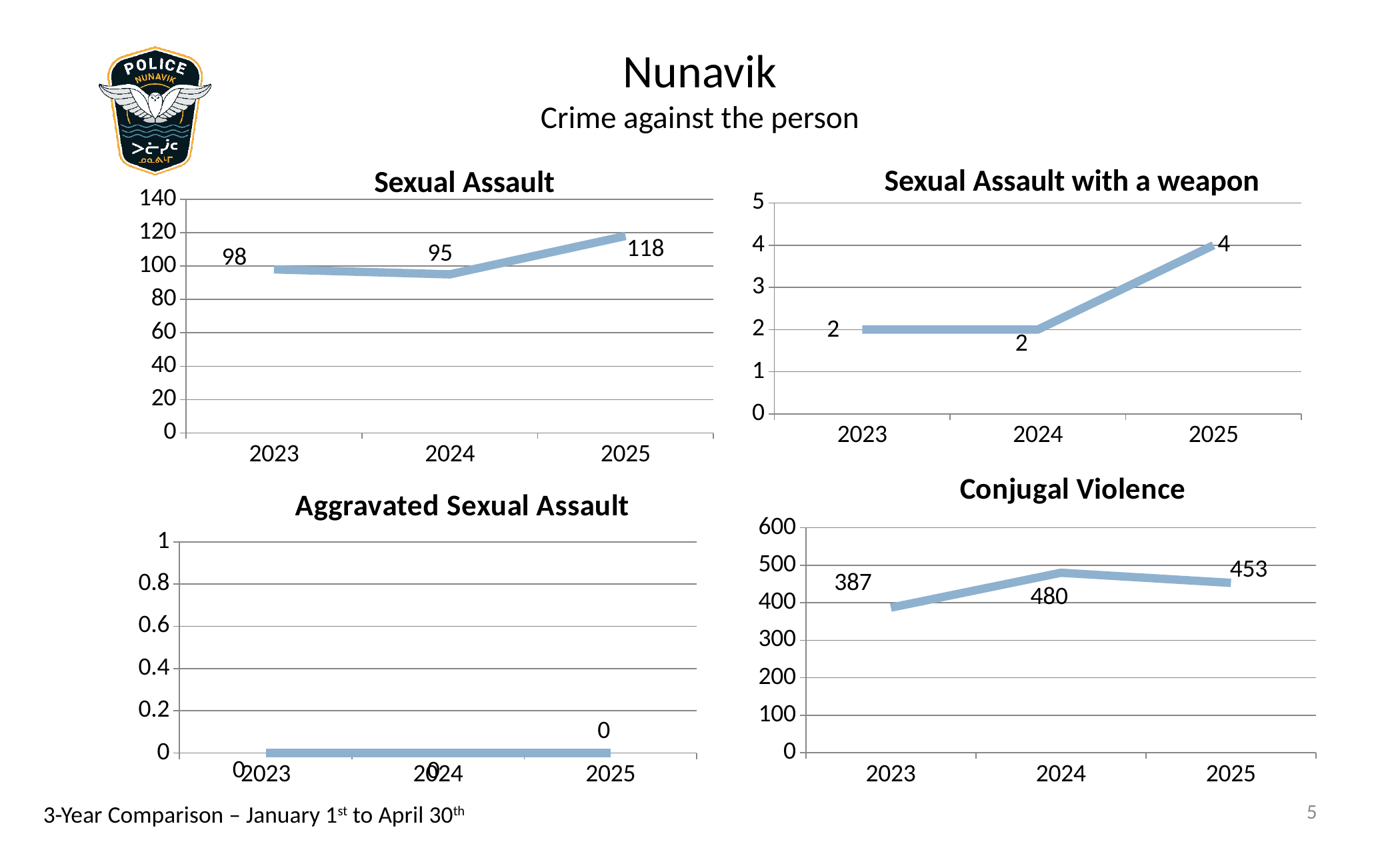
In the Sexual Assault with a weapon chart, which year has the highest value? 2025 In the Conjugal Violence chart, what is the difference between the 2024 and 2023 values? 93 In the Conjugal Violence chart, is the value for 2024 larger or smaller than the value for 2025? larger In the Sexual Assault chart, what is the difference between the 2025 and 2023 values? 20 In the Sexual Assault chart, which year has the lowest value? 2024 In the Conjugal Violence chart, what is the value for 2024? 480 In the Sexual Assault with a weapon chart, what is the value for 2025? 4 In the Sexual Assault chart, what is the value for 2025? 118 In the Sexual Assault with a weapon chart, what is the value for 2023? 2 In the Aggravated Sexual Assault chart, what is the value for 2025? 0 In the Conjugal Violence chart, which year has the lowest value? 2023 How many charts are on the slide? 4